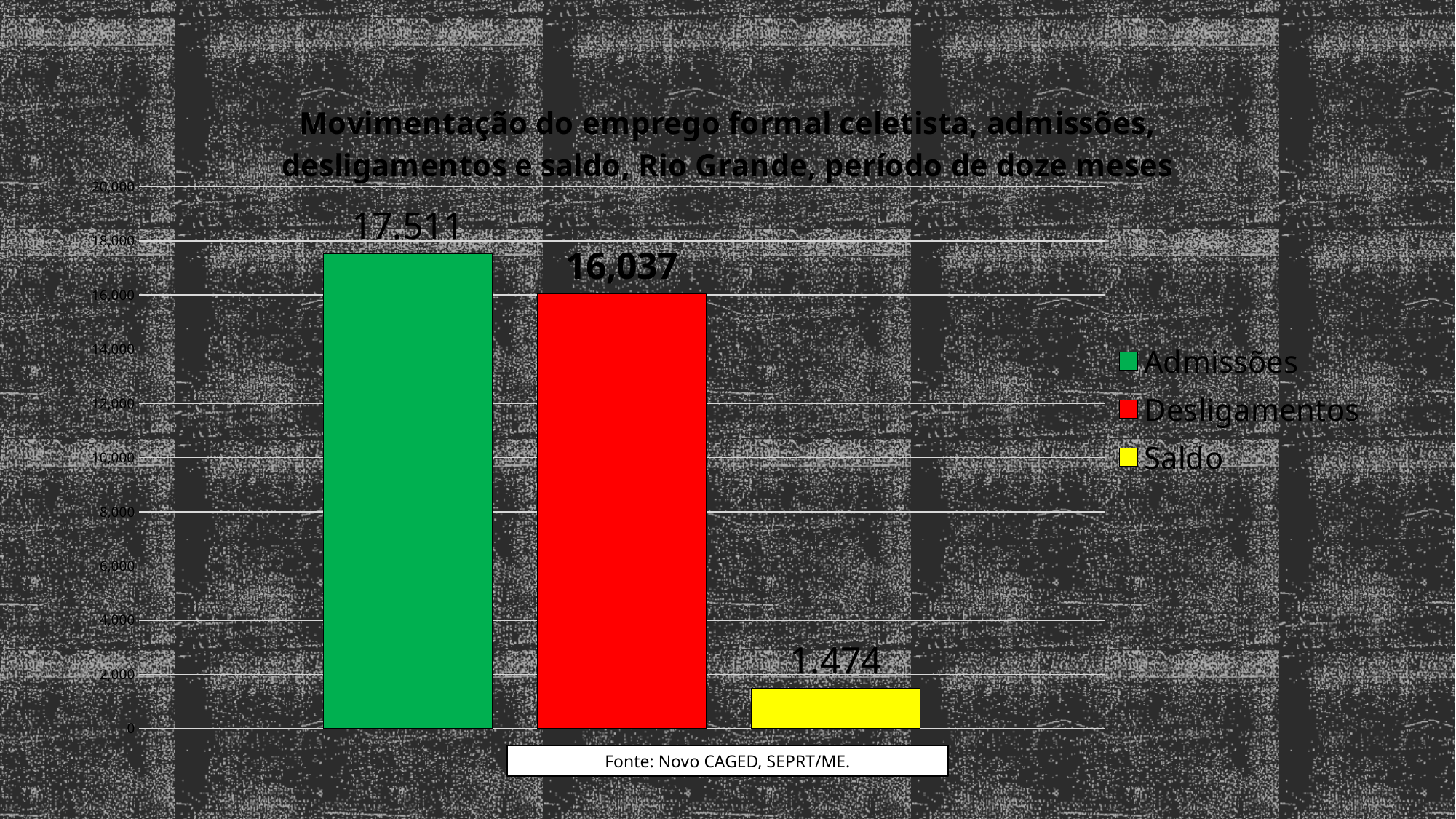
Which is larger, Admissões or Desligamentos? Admissões Which series has the highest value? Admissões What kind of chart is shown on the slide? Bar chart What is the value for Desligamentos? 16,037 Which series has the lowest value? Saldo What is the value for Saldo? 1.474 What is the value for Admissões? 17.511 How many series does the legend list? 3 How many bars are plotted on the chart? 3 What colour is the bar for Saldo? Yellow What is the difference between Admissões and Desligamentos? 1,474 What is the difference between Desligamentos and Saldo? 14,563